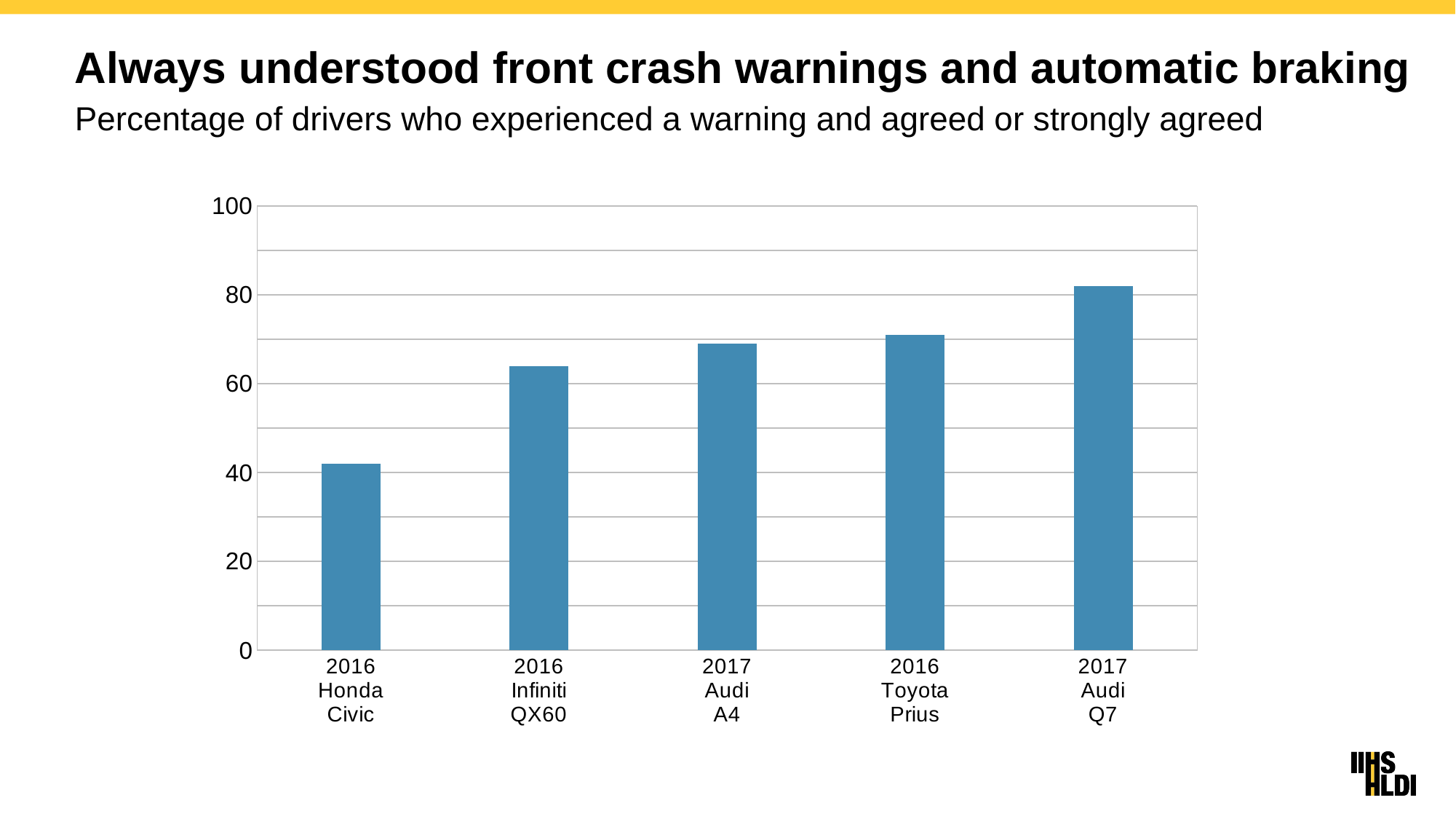
Which vehicle has the lowest percentage of drivers who always understood front crash warnings and automatic braking? 2016 Honda Civic Is the value for the 2016 Infiniti QX60 greater or less than 60? greater How many vehicle categories are shown on the x axis? 5 Which has a larger value, the 2016 Honda Civic or the 2016 Infiniti QX60? 2016 Infiniti QX60 Do the bar values rise or fall from left to right across the x axis? rise Is the value for the 2017 Audi Q7 greater or less than 80? greater What is the title of the chart on the slide? Always understood front crash warnings and automatic braking Is the value for the 2016 Toyota Prius greater or less than 80? less Which has a larger value, the 2017 Audi A4 or the 2017 Audi Q7? 2017 Audi Q7 What kind of chart is shown on the slide? bar chart Which vehicle has the highest percentage of drivers who always understood front crash warnings and automatic braking? 2017 Audi Q7